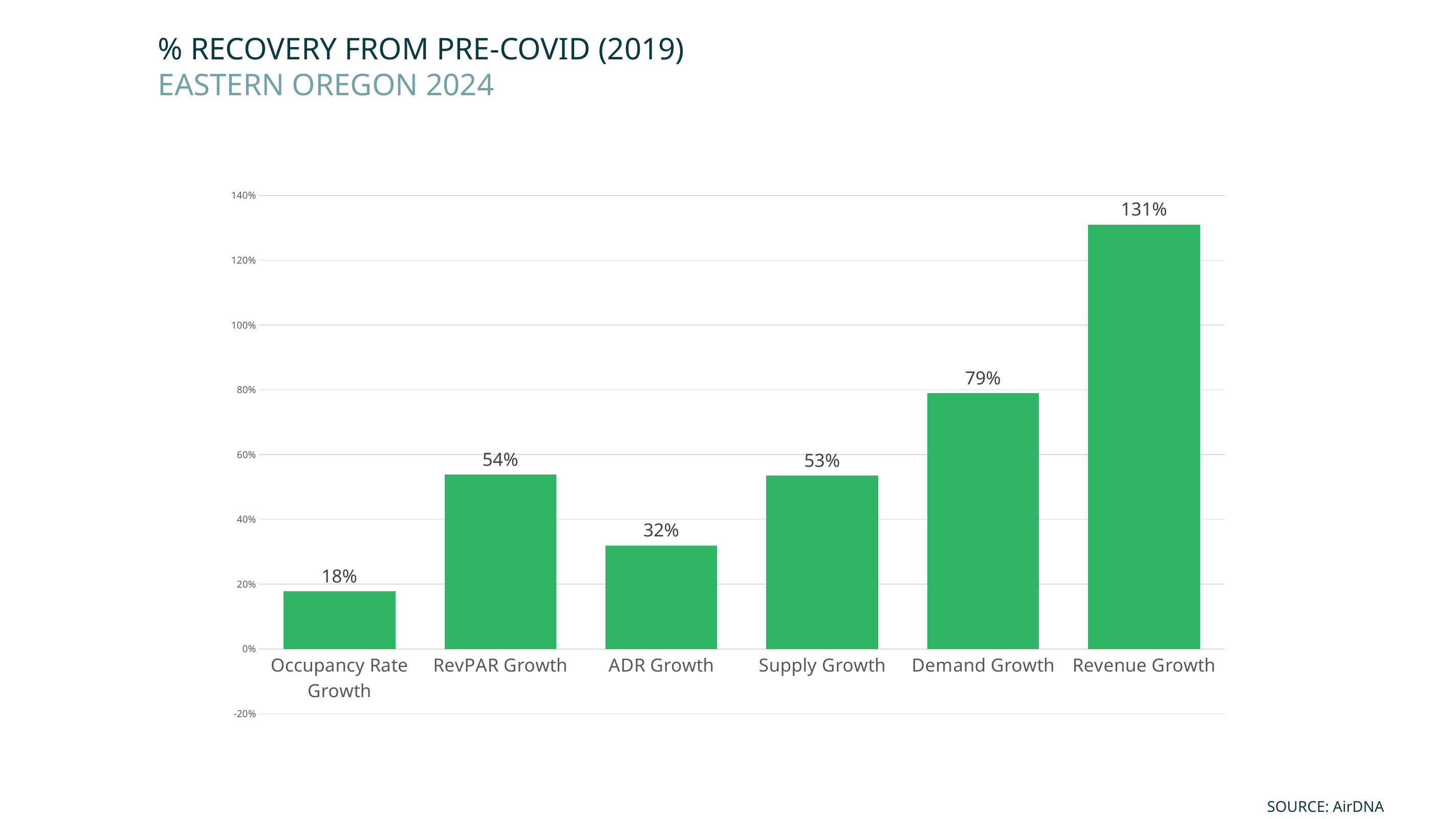
Which category has the lowest value? Occupancy Rate Growth What kind of chart is shown on the slide? Bar chart What is the value for Demand Growth? 79% How many categories are shown on the chart? 6 Which category has the highest value? Revenue Growth What is the difference between Revenue Growth and Demand Growth? 52% Which is larger, Demand Growth or Supply Growth? Demand Growth What is the difference between RevPAR Growth and ADR Growth? 22% What is the value for ADR Growth? 32% What is the value for Revenue Growth? 131% What is the source cited for the chart? AirDNA What is the value for Occupancy Rate Growth? 18%